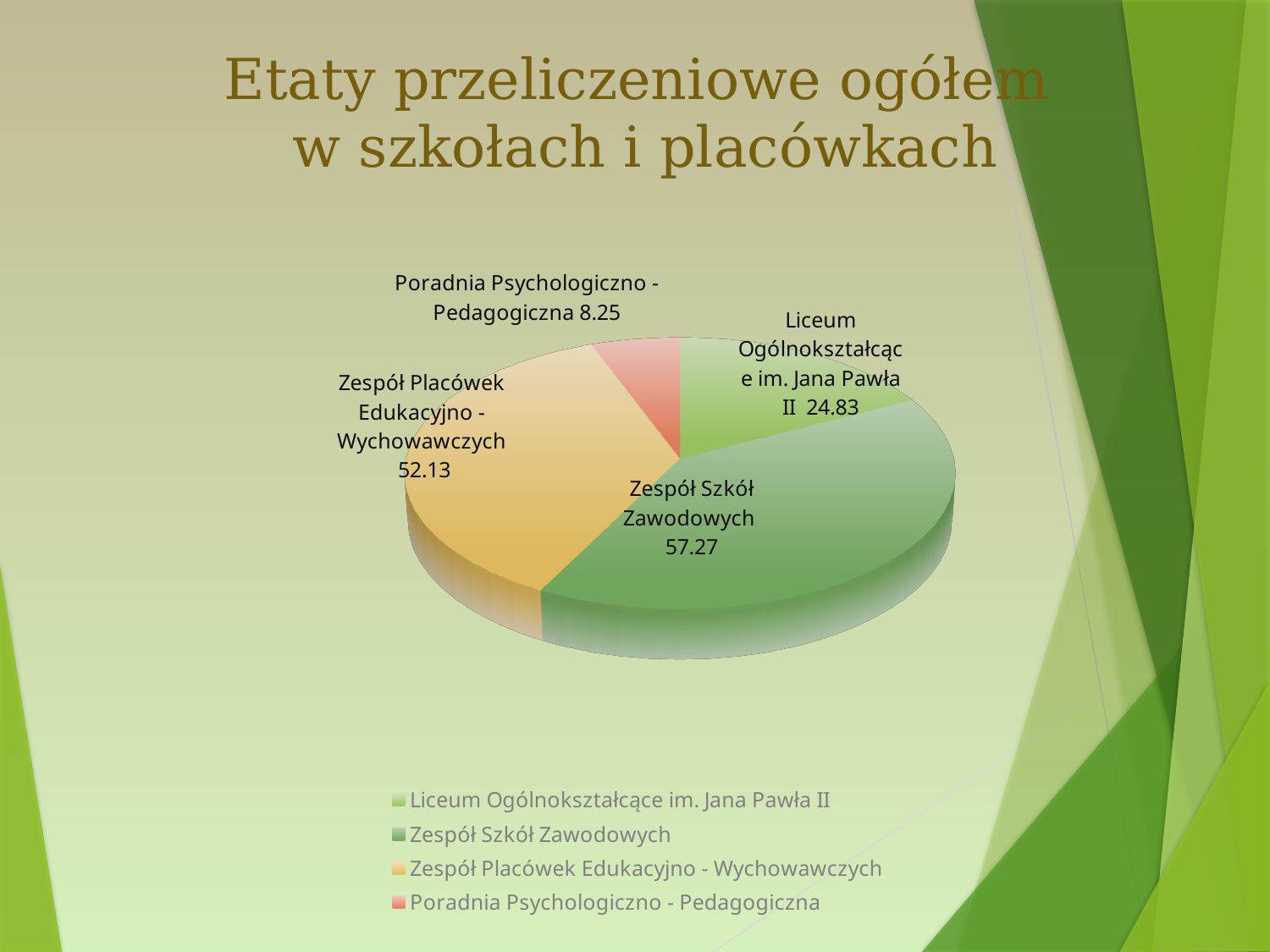
How many slices does the pie chart have? 4 Which category has the largest slice of the pie? Zespół Szkół Zawodowych What value is shown for Zespół Placówek Edukacyjno - Wychowawczych? 52.13 What kind of chart is shown on the slide? Pie chart What value is shown for Poradnia Psychologiczno - Pedagogiczna? 8.25 What value is shown for Zespół Szkół Zawodowych? 57.27 What is the title of the slide containing the chart? Etaty przeliczeniowe ogółem w szkołach i placówkach Which is larger: the value for Zespół Szkół Zawodowych or for Zespół Placówek Edukacyjno - Wychowawczych? Zespół Szkół Zawodowych Which category has the smallest slice of the pie? Poradnia Psychologiczno - Pedagogiczna What is the difference between the values for Zespół Szkół Zawodowych and Zespół Placówek Edukacyjno - Wychowawczych? 5.14 What is the difference between the values for Liceum Ogólnokształcące im. Jana Pawła II and Poradnia Psychologiczno - Pedagogiczna? 16.58 What value is shown for Liceum Ogólnokształcące im. Jana Pawła II? 24.83